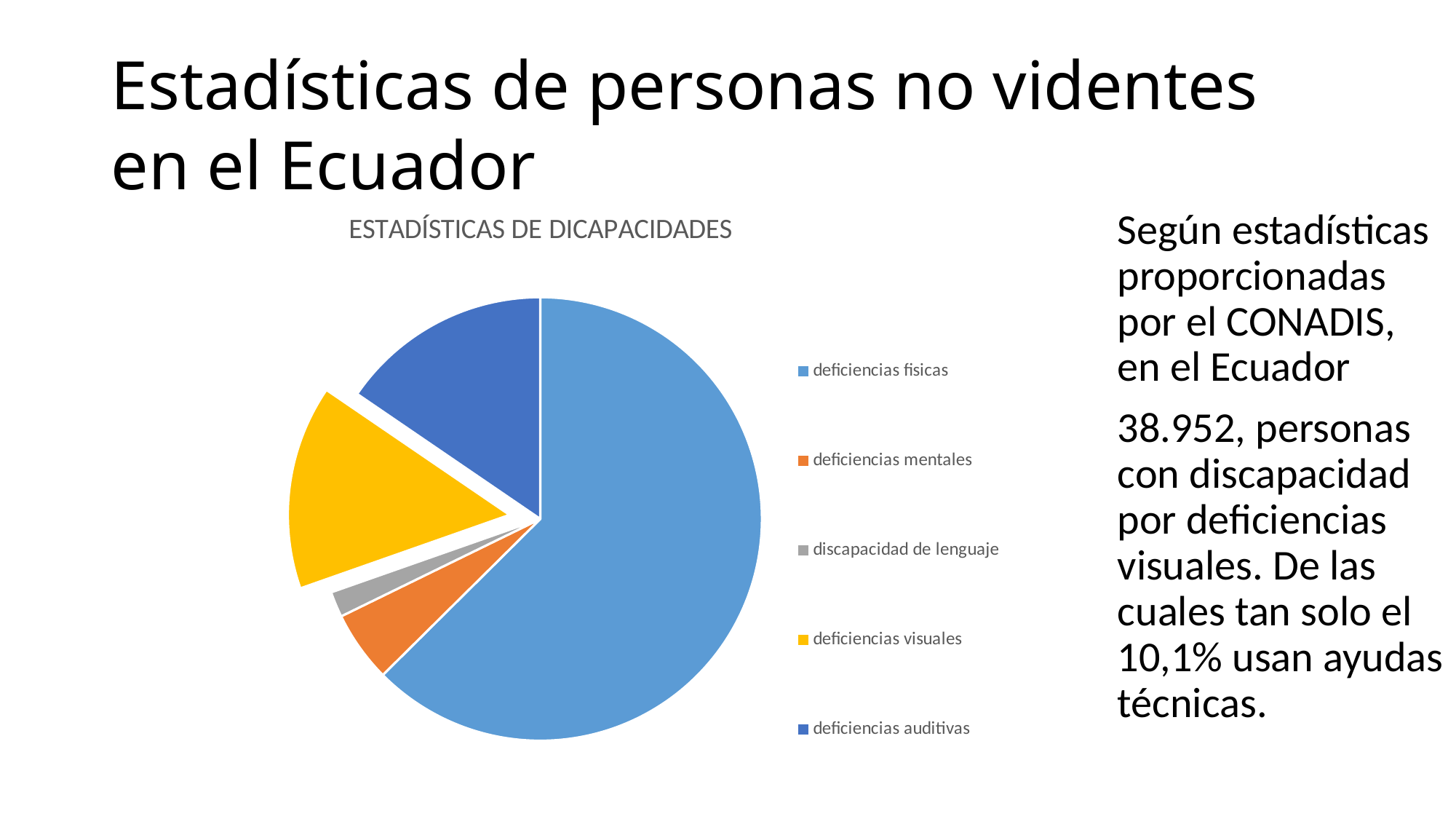
Which category is shown in yellow and pulled out from the rest of the pie? deficiencias visuales Which slice is larger, deficiencias auditivas or deficiencias mentales? deficiencias auditivas How many categories does the pie chart show? 5 Does the deficiencias fisicas slice account for more or less than half of the pie? more Which slice is larger, deficiencias mentales or discapacidad de lenguaje? deficiencias mentales Which category has the largest slice of the pie? deficiencias fisicas What is the title of the chart? ESTADÍSTICAS DE DICAPACIDADES Which slice is larger, deficiencias fisicas or deficiencias visuales? deficiencias fisicas Which category has the smallest slice of the pie? discapacidad de lenguaje What kind of chart is shown on the slide? pie chart